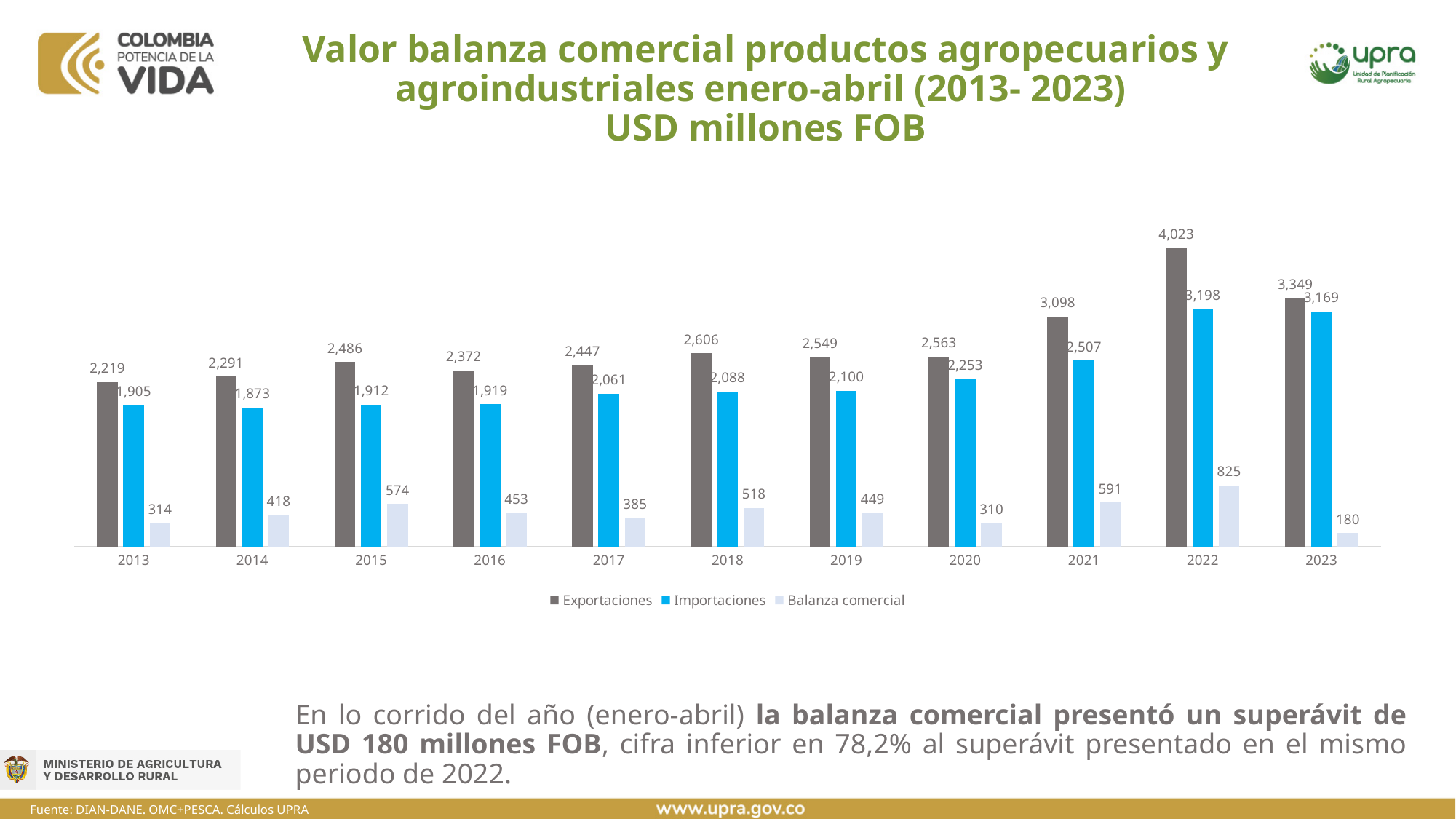
In which year is Importaciones lowest? 2014 What is the value of Exportaciones in 2022? 4,023 What is the difference between Exportaciones and Importaciones in 2023? 180 What kind of chart is shown on the slide? Bar chart What is the value of Importaciones in 2019? 2,100 In which year is Balanza comercial lowest? 2023 How many years are shown on the x axis? 11 Which is larger, Importaciones in 2022 or Importaciones in 2023? Importaciones in 2022 In which year is Balanza comercial highest? 2022 What is the value of Balanza comercial in 2015? 574 What is the difference between Exportaciones in 2022 and Exportaciones in 2021? 925 How many series does the legend list? 3